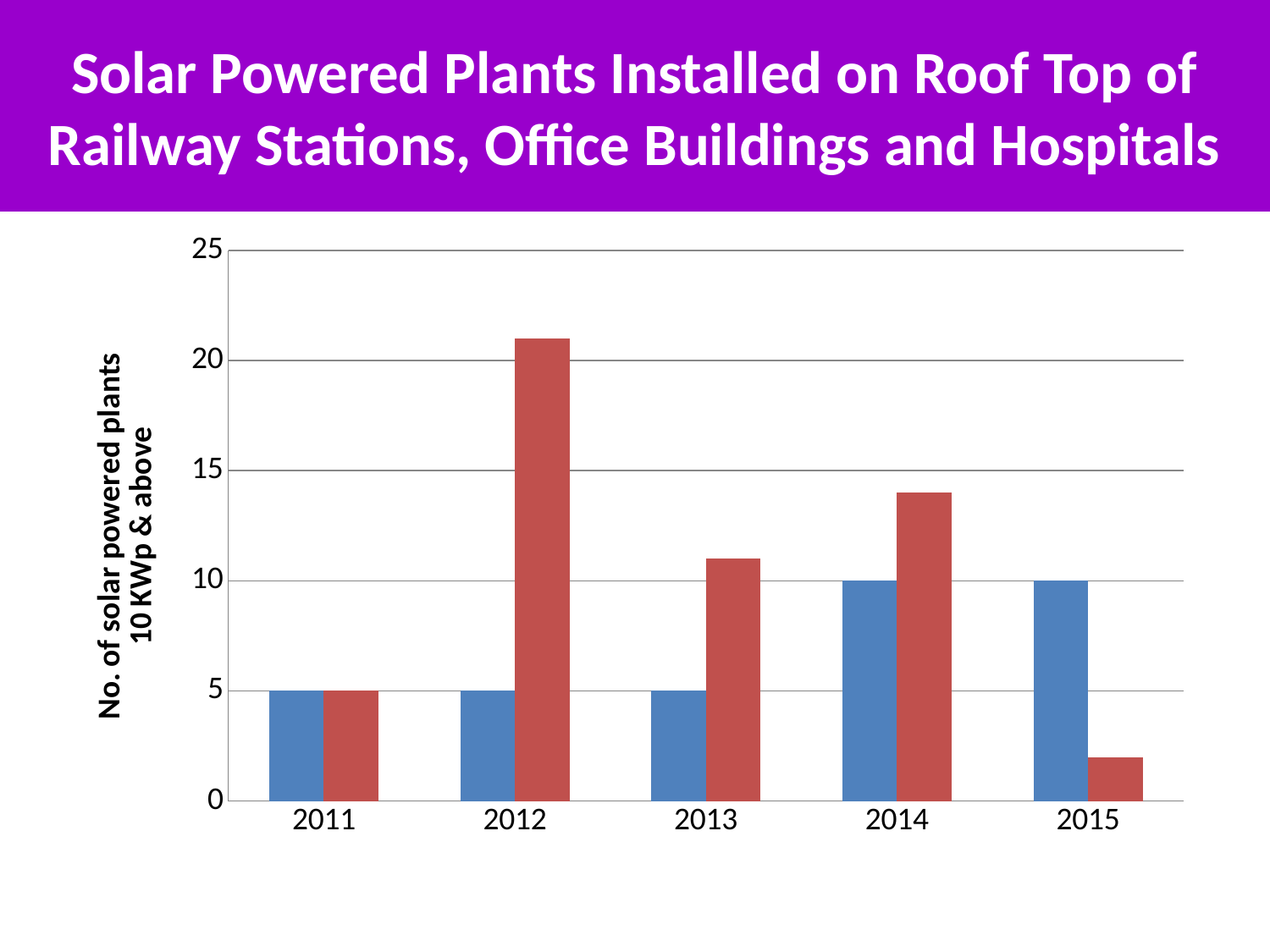
How many years are shown on the x axis of the chart? 5 Is the value of the red bar for 2014 greater or less than 15? less What is the value of the blue bar for 2011? 5 What is the title of the vertical axis? No. of solar powered plants 10 KWp & above In 2012, which bar is taller, the blue bar or the red bar? the red bar What kind of chart is shown on the slide? bar chart In which year is the red bar highest? 2012 What is the value of the red bar for 2011? 5 Is the value of the red bar for 2012 greater or less than 20? greater What is the difference between the blue bar for 2014 and the blue bar for 2011? 5 In which year is the red bar lowest? 2015 What is the value of the blue bar for 2014? 10